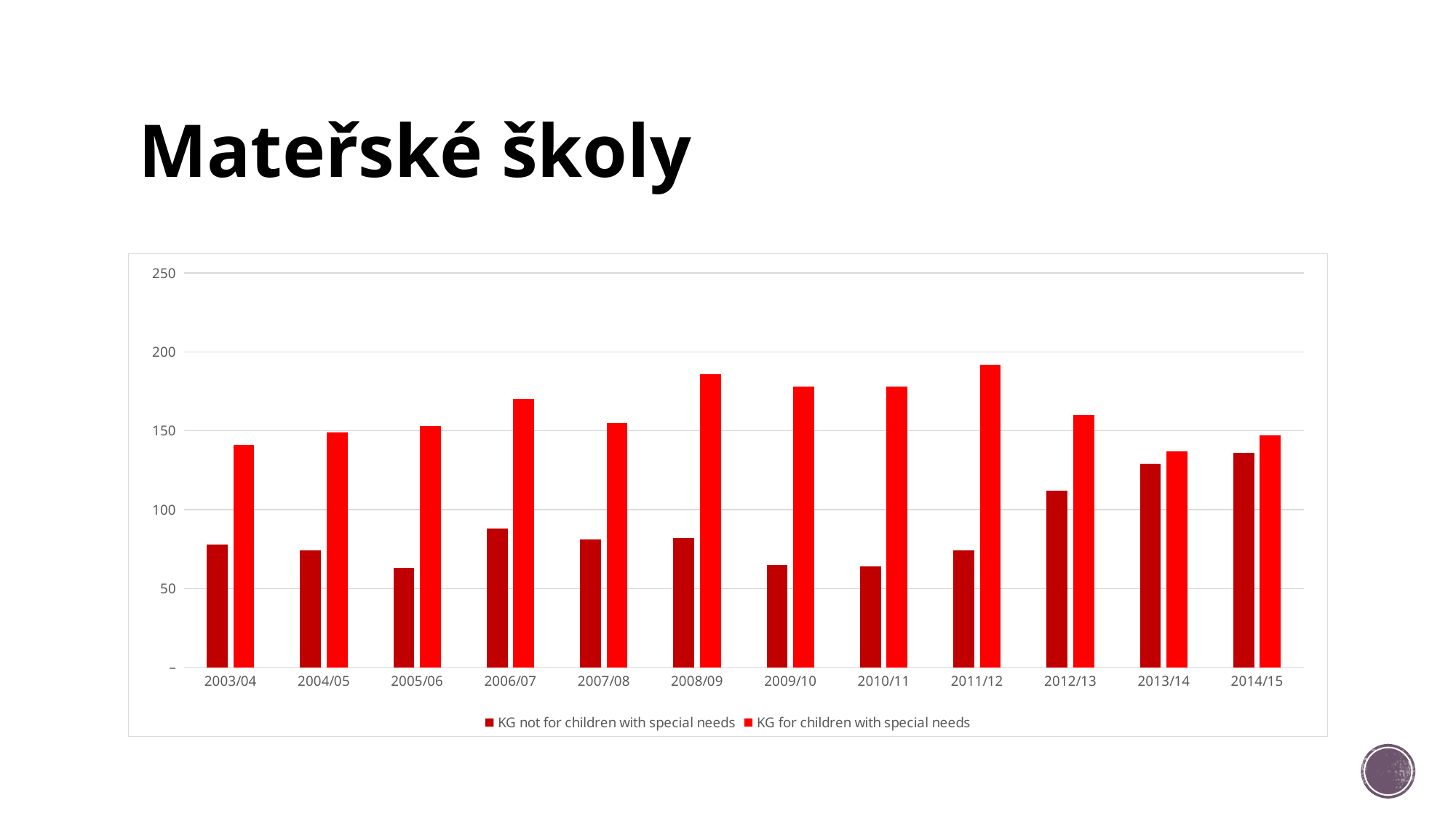
In which school year is the value for KG not for children with special needs highest? 2014/15 Do the values for KG not for children with special needs rise or fall from 2011/12 to 2014/15? rise Is the value for KG for children with special needs in 2008/09 greater or less than 150? greater What is the title of the slide containing the chart? Mateřské školy Is the value for KG not for children with special needs in 2012/13 greater or less than 100? greater Which is larger: the value for KG for children with special needs in 2006/07 or in 2007/08? 2006/07 In which school year is the value for KG for children with special needs highest? 2011/12 What kind of chart is shown on the slide? bar chart How many school years are shown on the x axis? 12 Is the value for KG for children with special needs in 2011/12 greater or less than 200? less How many series does the legend list? 2